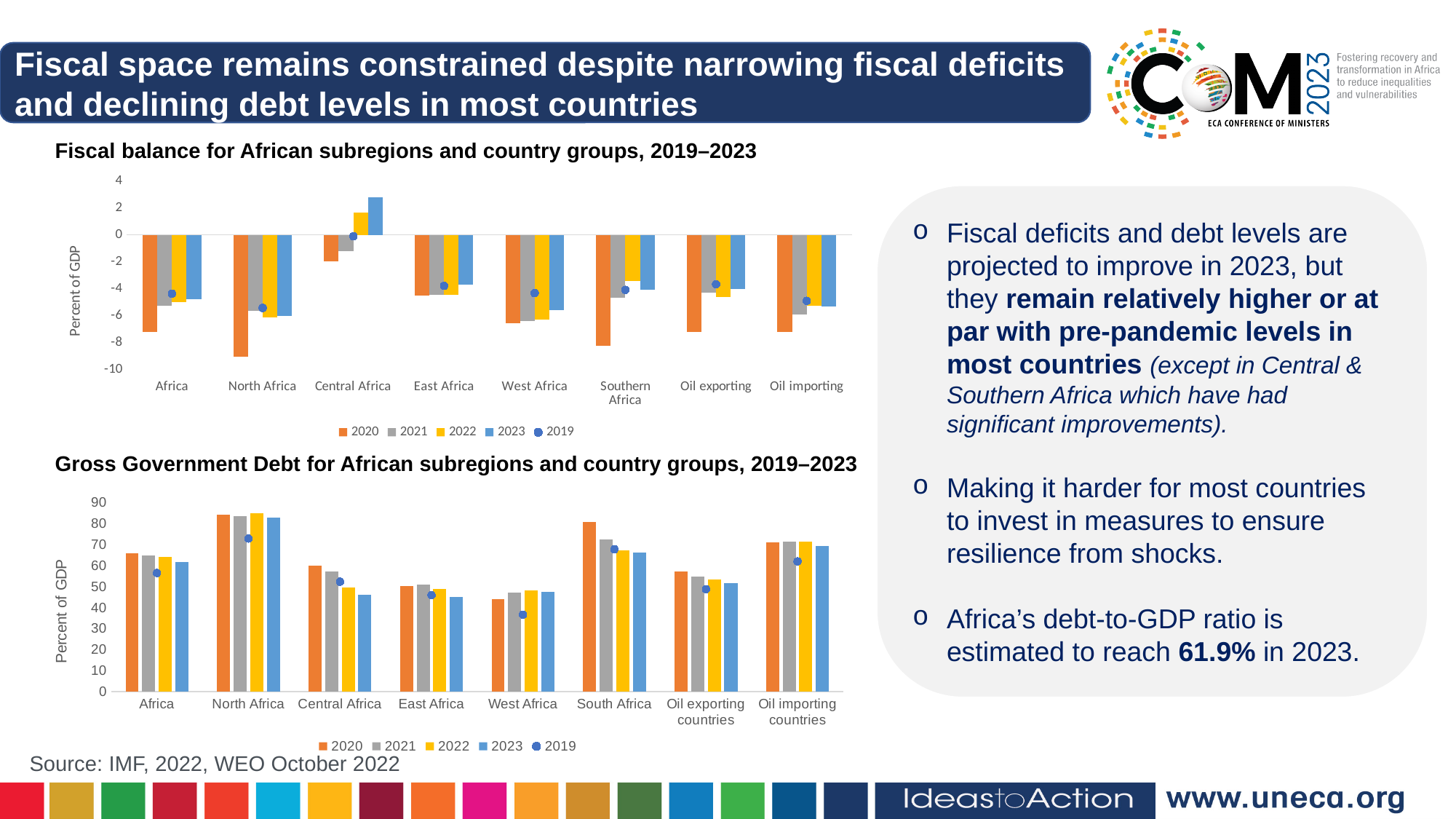
In the 'Fiscal balance for African subregions and country groups, 2019–2023' chart, how many categories are shown on the x axis? 8 In the 'Gross Government Debt for African subregions and country groups, 2019–2023' chart, is the 2020 value for West Africa greater or less than 50? less In the 'Fiscal balance for African subregions and country groups, 2019–2023' chart, how many series does the legend list? 5 In the 'Gross Government Debt for African subregions and country groups, 2019–2023' chart, is the 2020 value for North Africa greater or less than 80? greater What kind of chart is the 'Gross Government Debt for African subregions and country groups, 2019–2023' chart? Bar chart In the 'Gross Government Debt for African subregions and country groups, 2019–2023' chart, which category has the lowest 2020 value? West Africa In the 'Fiscal balance for African subregions and country groups, 2019–2023' chart, which category has the lowest 2020 value? North Africa In the 'Gross Government Debt for African subregions and country groups, 2019–2023' chart, which is larger for 2020: South Africa or Oil exporting countries? South Africa In the 'Gross Government Debt for African subregions and country groups, 2019–2023' chart, which category has the highest 2020 value? North Africa In the 'Fiscal balance for African subregions and country groups, 2019–2023' chart, which category has the highest 2023 value? Central Africa In the 'Fiscal balance for African subregions and country groups, 2019–2023' chart, is the 2020 value for North Africa greater or less than -8? less